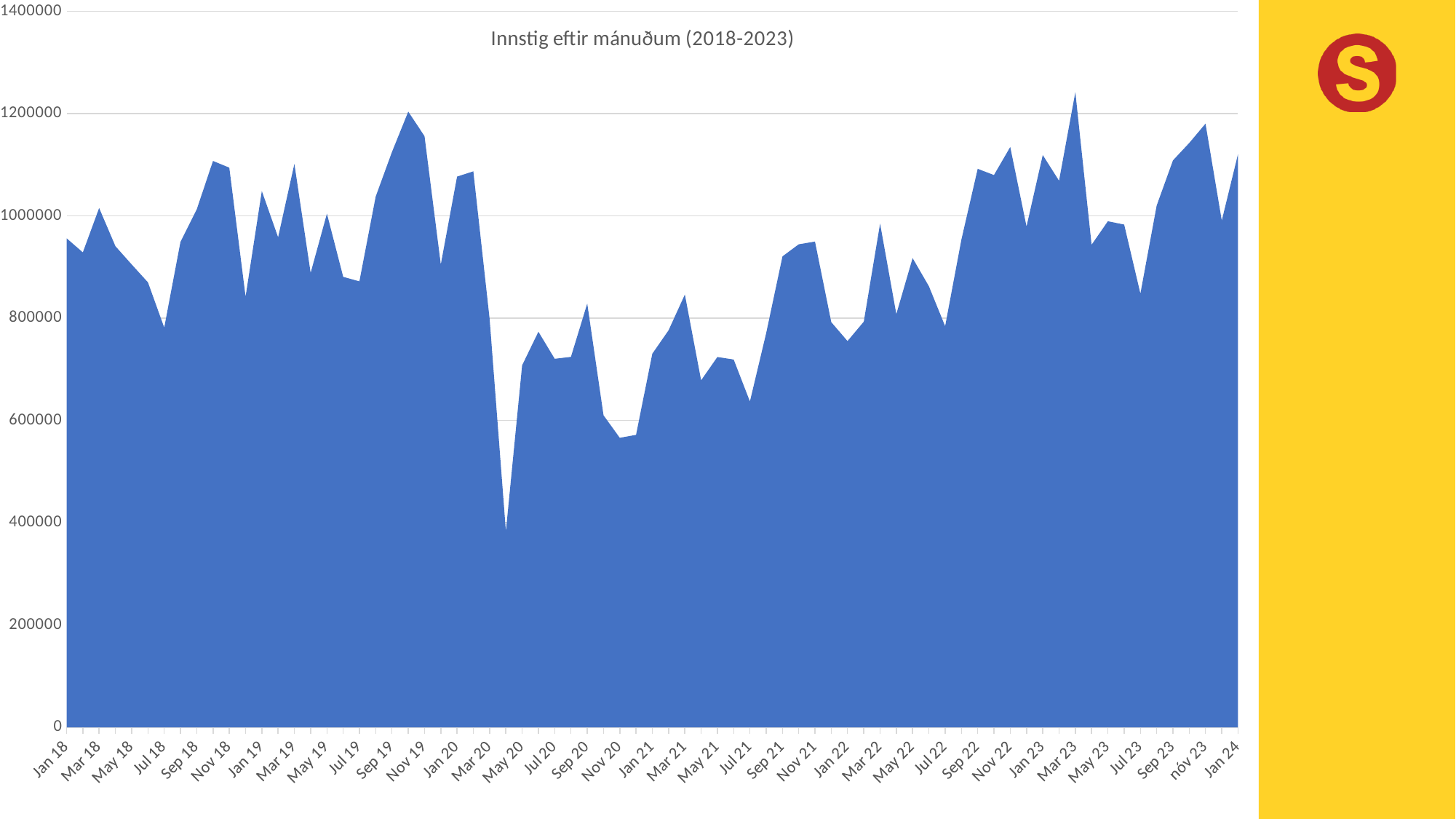
What kind of chart is shown on the slide? Area chart What is the title of the chart? Innstig eftir mánuðum (2018-2023) Is the value for Nov 19 greater or less than 1000000? greater What is the highest value shown on the vertical axis? 1400000 How many month labels are shown on the horizontal axis? 37 Do the values rise or fall from Jan 20 to May 20? fall Is the value for Jan 18 greater or less than 800000? greater Is the value for Jan 24 greater or less than 1000000? greater Which is larger, the value for Jan 18 or the value for May 20? Jan 18 Which is larger, the value for Nov 19 or the value for Nov 20? Nov 19